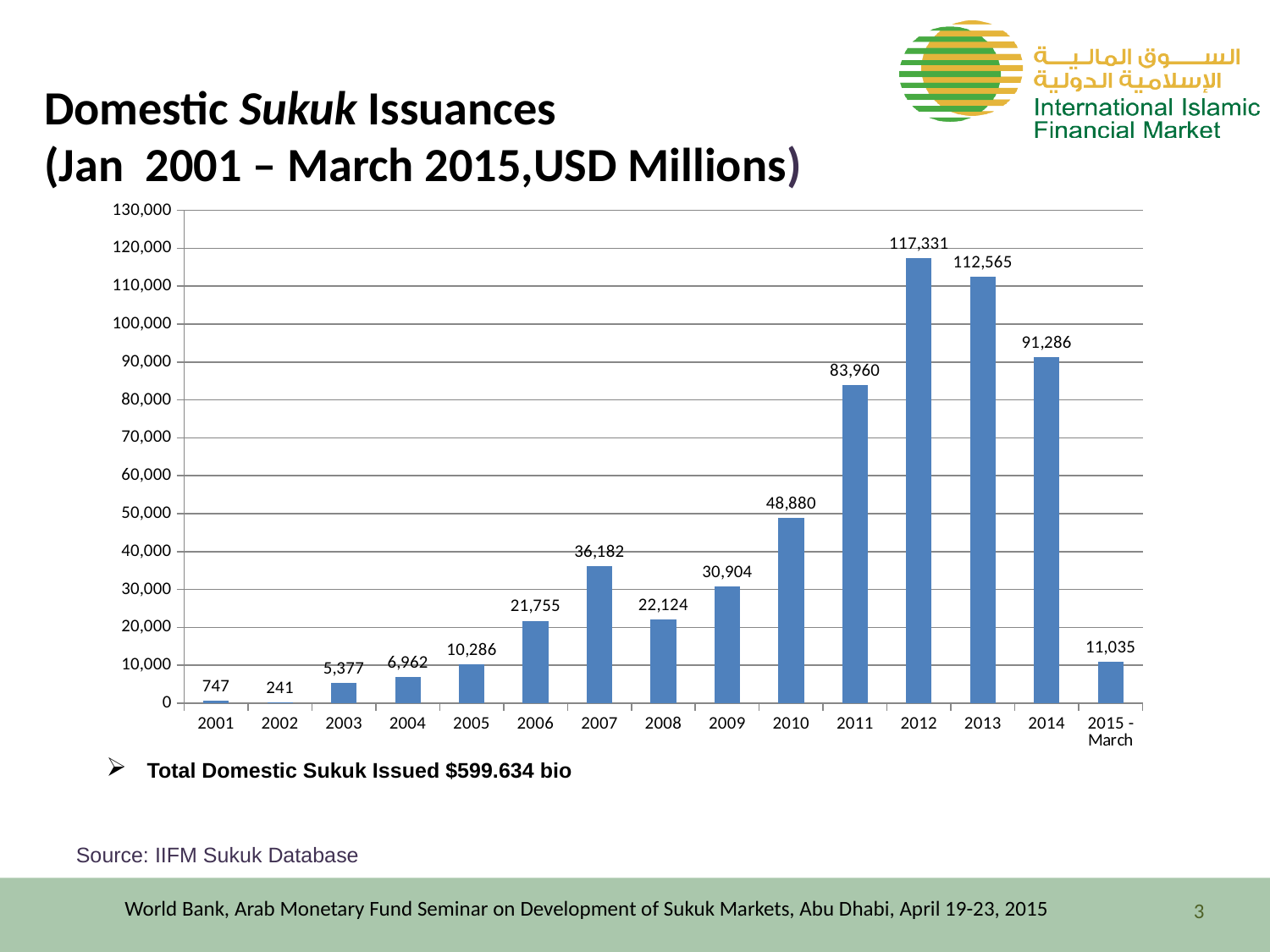
Which is larger, the value for 2007 or the value for 2009? 2007 Is the value for 2014 greater or less than 100,000? less What is the value shown for 2015 - March? 11,035 Do the values rise or fall from 2008 to 2012? Rise What is the value of domestic Sukuk issuances for 2012? 117,331 What is the value shown for 2005? 10,286 What is the difference between the values for 2012 and 2013? 4,766 Which year has the highest domestic Sukuk issuance value? 2012 Which year has the lowest domestic Sukuk issuance value? 2002 How many bars (time periods) are shown in the chart? 15 What type of chart is shown on the slide? Bar chart What is the difference between the values for 2011 and 2010? 35,080